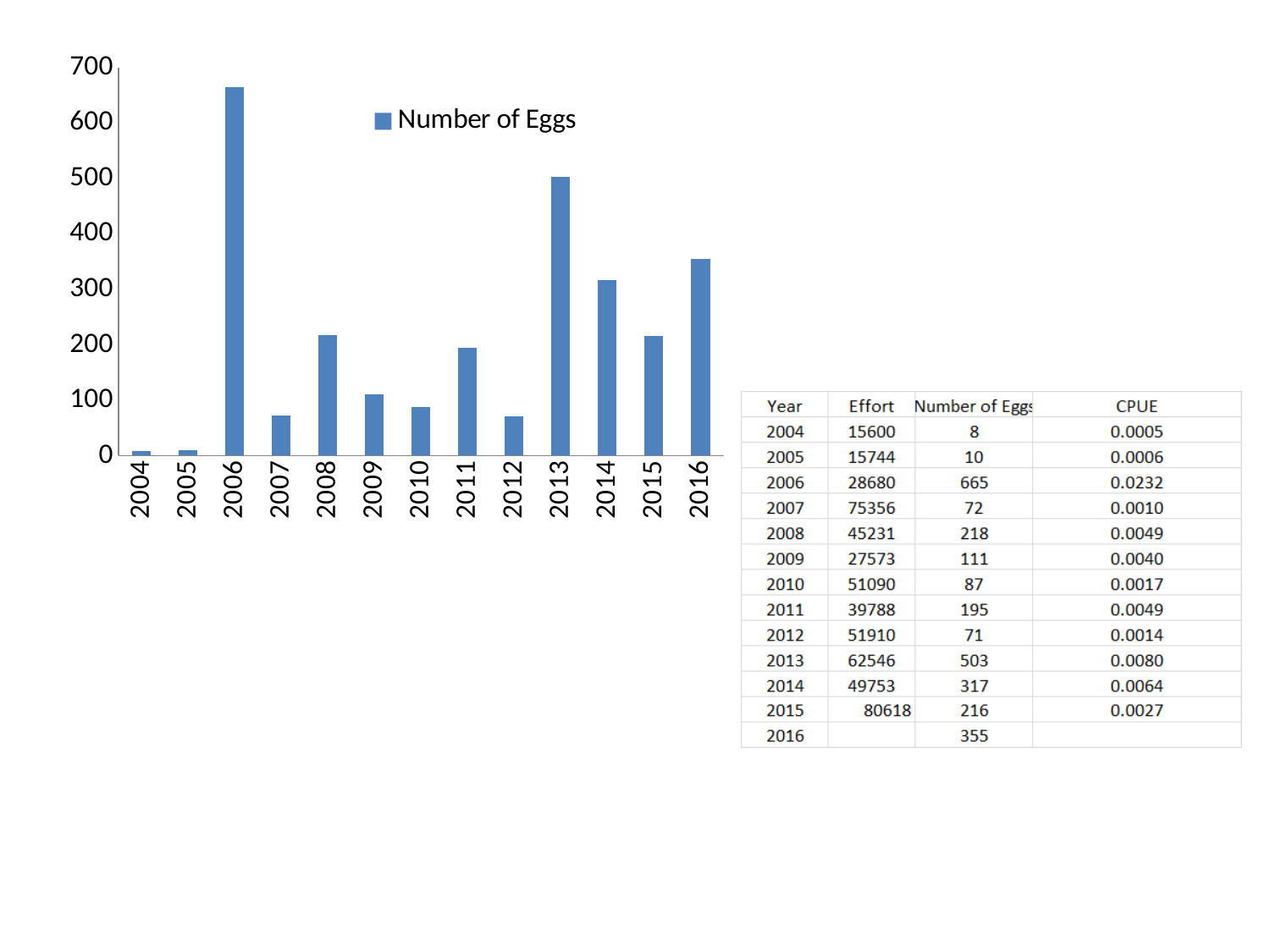
Do the values rise or fall from 2013 to 2015? fall Is the value for 2016 greater or less than 300? greater Which year has the larger number of eggs, 2013 or 2014? 2013 Which year has the highest number of eggs in the chart? 2006 What kind of chart is shown on the slide? bar chart Is the value for 2007 greater or less than 100? less How many series does the chart's legend list? 1 Is the value for 2013 greater or less than 400? greater How many years are shown along the x axis of the chart? 13 What is the name of the series shown in the chart's legend? Number of Eggs